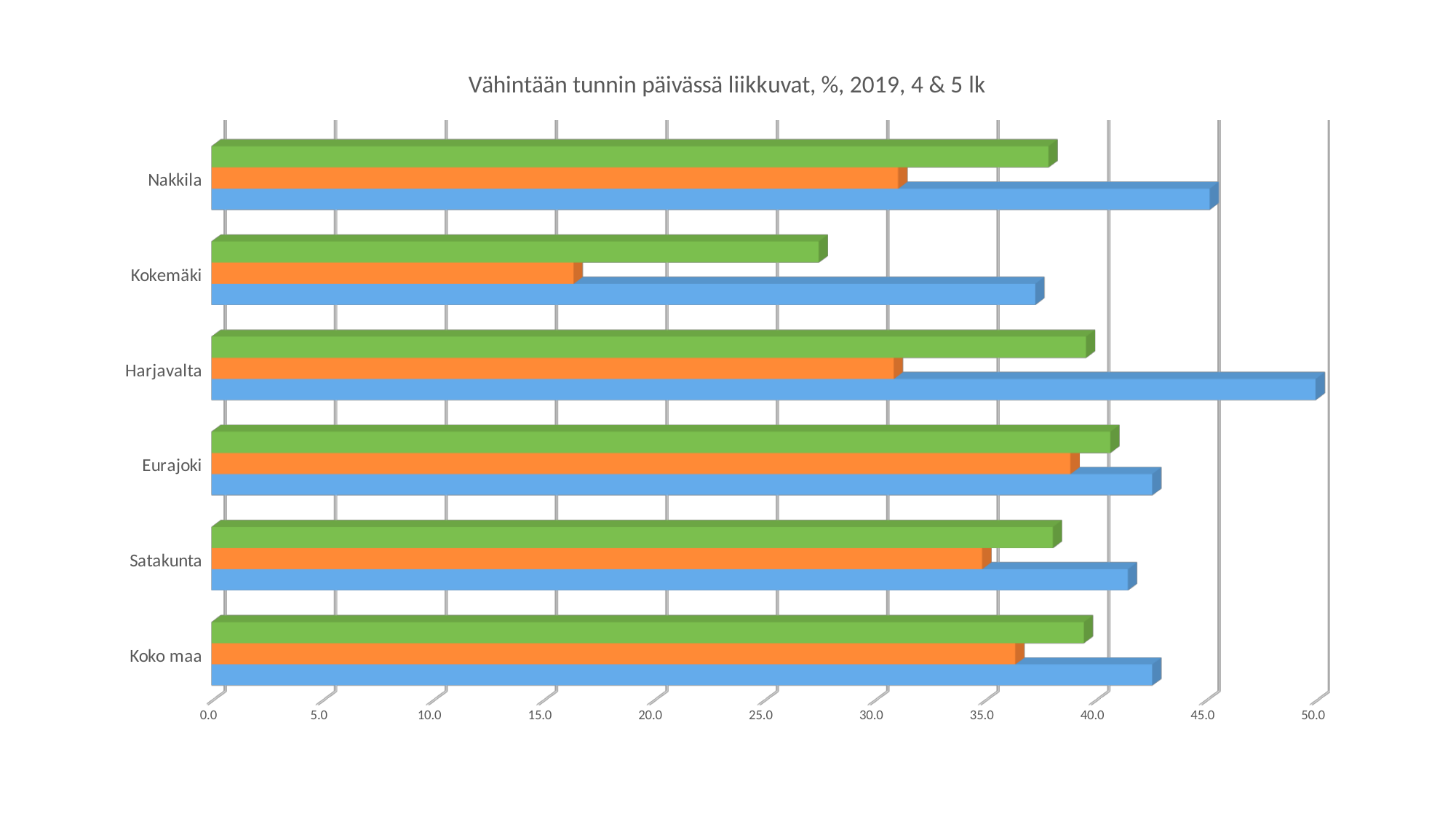
Which is larger, the blue bar for Nakkila or the blue bar for Kokemäki? Nakkila What is the title of the chart? Vähintään tunnin päivässä liikkuvat, %, 2019, 4 & 5 lk How many categories are shown on the vertical axis of the chart? 6 Is the orange bar for Kokemäki greater or less than 20.0? less Which is larger, the orange bar for Eurajoki or the orange bar for Harjavalta? Eurajoki Is the blue bar for Nakkila greater or less than 40.0? greater Is the blue bar for Harjavalta greater or less than 45.0? greater Which category has the shortest orange bar? Kokemäki Which category has the longest blue bar? Harjavalta What kind of chart is shown on the slide? Bar chart How many bars are plotted for each category in the chart? 3